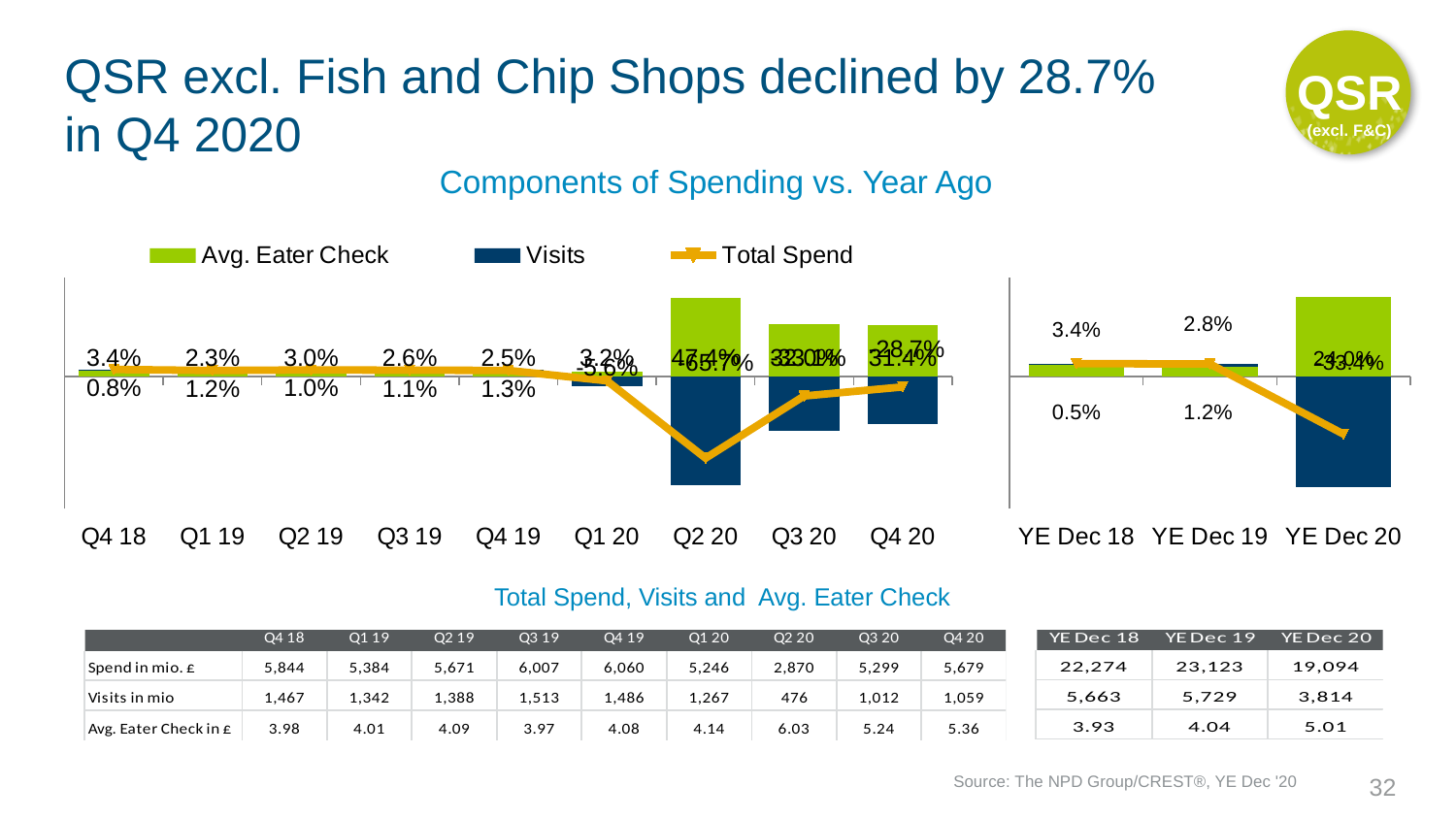
On the right yearly chart, what is the Avg. Eater Check value for YE Dec 18? 3.4% How many series does the legend list for the Components of Spending vs. Year Ago charts? 3 On the left quarterly chart, what is the Avg. Eater Check value for Q2 19? 3.0% On the left quarterly chart, what is the Visits value for Q4 19? 1.3% On the left quarterly chart, which quarter has the lowest Visits bar? Q2 20 On the left quarterly chart, does the Total Spend line rise or fall from Q4 19 to Q2 20? fall On the left quarterly chart, which is larger: the Visits value for Q4 18 or for Q1 19? Q1 19 How many quarters are shown on the left quarterly chart? 9 On the right yearly chart, what is the Visits value for YE Dec 19? 1.2% On the left quarterly chart, which quarter has the highest Avg. Eater Check bar? Q2 20 On the left quarterly chart, what is the difference between the Avg. Eater Check values for Q4 18 and Q1 19? 1.1% On the left quarterly chart, what is the Avg. Eater Check value for Q4 18? 3.4%